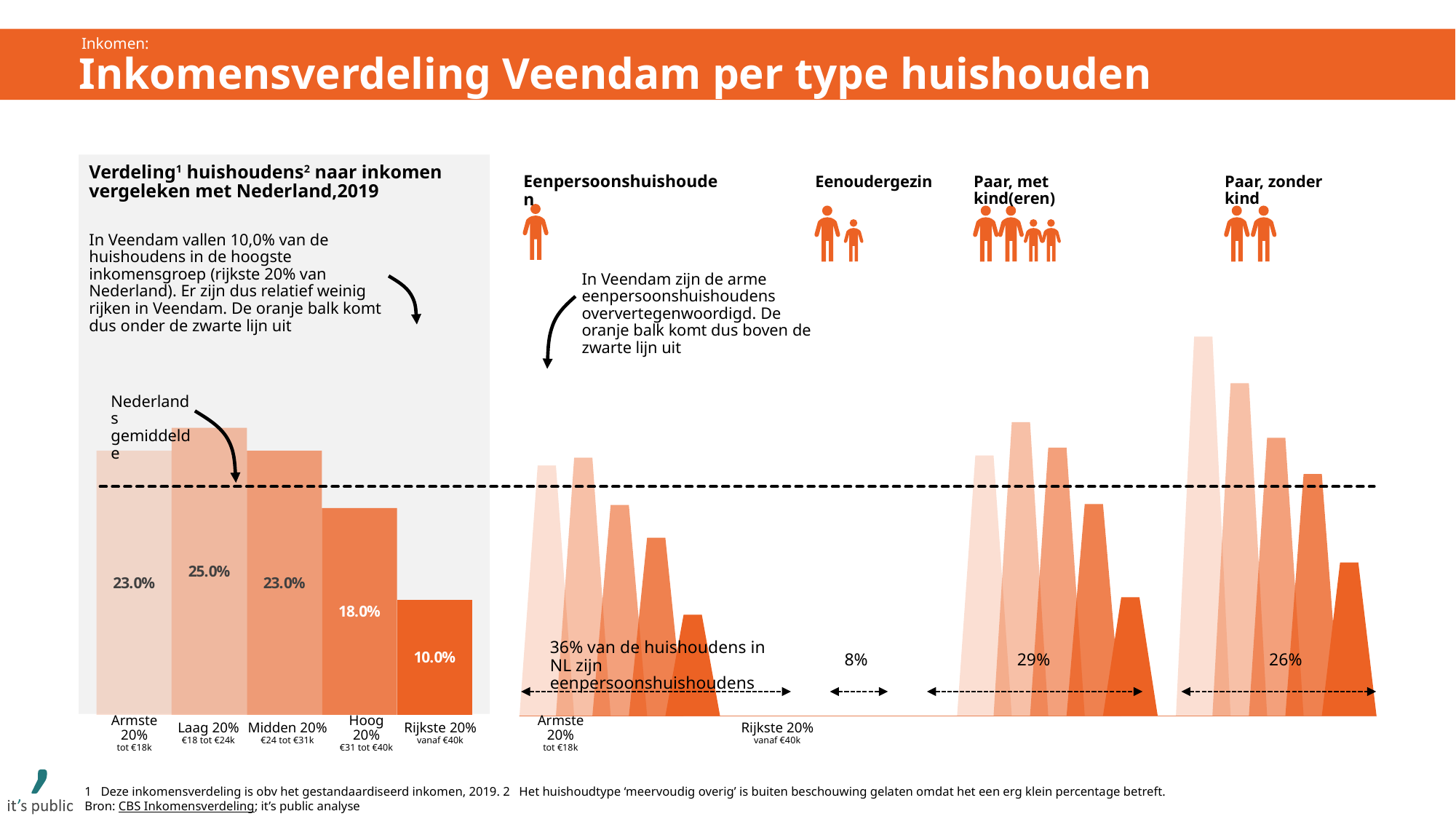
In the left chart 'Verdeling huishoudens naar inkomen vergeleken met Nederland, 2019', what is the value for Laag 20%? 25.0% What kind of chart is the left chart 'Verdeling huishoudens naar inkomen vergeleken met Nederland, 2019'? Bar chart In the left chart 'Verdeling huishoudens naar inkomen vergeleken met Nederland, 2019', what is the difference between the values for Laag 20% and Rijkste 20%? 15.0% In the left chart 'Verdeling huishoudens naar inkomen vergeleken met Nederland, 2019', do the values rise or fall from Midden 20% to Rijkste 20%? Fall In the left chart 'Verdeling huishoudens naar inkomen vergeleken met Nederland, 2019', what is the value for Rijkste 20%? 10.0% In the left chart 'Verdeling huishoudens naar inkomen vergeleken met Nederland, 2019', what is the difference between the values for Hoog 20% and Rijkste 20%? 8.0% In the right-hand chart, what share of households in the Netherlands are 'Paar, met kind(eren)'? 29% In the left chart 'Verdeling huishoudens naar inkomen vergeleken met Nederland, 2019', what is the value for Hoog 20%? 18.0% In the left chart 'Verdeling huishoudens naar inkomen vergeleken met Nederland, 2019', which income group has the lowest value? Rijkste 20% In the left chart 'Verdeling huishoudens naar inkomen vergeleken met Nederland, 2019', which is larger: the value for Midden 20% or the value for Hoog 20%? Midden 20% How many income groups are shown in the left chart 'Verdeling huishoudens naar inkomen vergeleken met Nederland, 2019'? 5 In the left chart 'Verdeling huishoudens naar inkomen vergeleken met Nederland, 2019', which income group has the highest value? Laag 20%